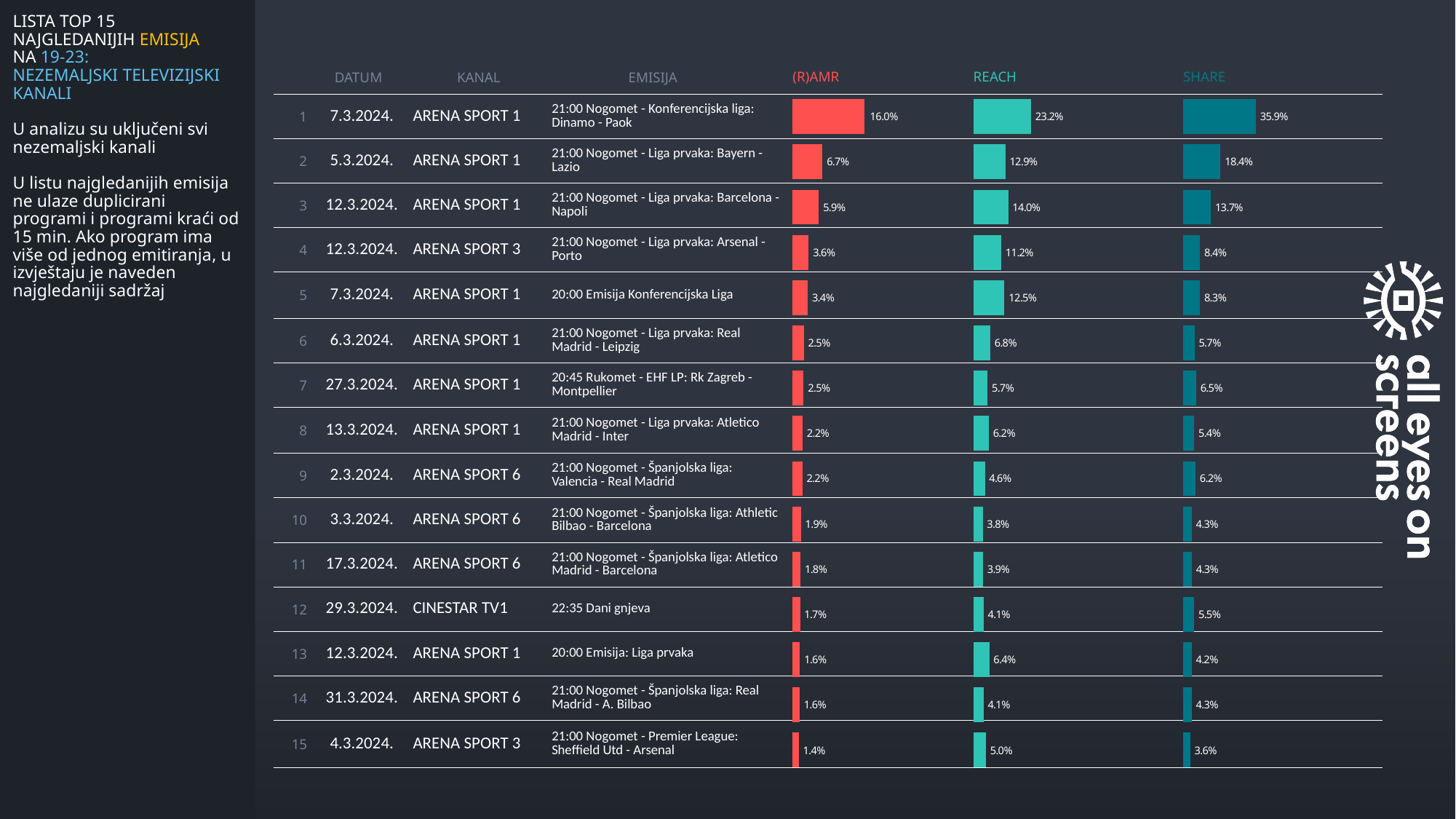
What is the REACH value for the rank 2 programme, 21:00 Nogomet - Liga prvaka: Bayern - Lazio? 12.9% Do the (R)AMR values rise or fall going down the list from rank 1 to rank 15? Fall Which programme has the highest SHARE value? 21:00 Nogomet - Konferencijska liga: Dinamo - Paok How many metric columns with bars are shown (R)AMR, REACH, SHARE)? 3 What is the (R)AMR value for the rank 1 programme, 21:00 Nogomet - Konferencijska liga: Dinamo - Paok? 16.0% Which has a higher REACH value: the rank 3 programme (Barcelona - Napoli) or the rank 5 programme (20:00 Emisija Konferencijska Liga)? 21:00 Nogomet - Liga prvaka: Barcelona - Napoli What colour are the bars in the (R)AMR column? Red What kind of chart is used to display the (R)AMR, REACH and SHARE values? Bar chart What is the SHARE value for the rank 4 programme, 21:00 Nogomet - Liga prvaka: Arsenal - Porto? 8.4% What is the difference in (R)AMR between the rank 1 programme (Dinamo - Paok) and the rank 2 programme (Bayern - Lazio)? 9.3% How many programmes are listed in the table? 15 Which programme has the lowest REACH value? 21:00 Nogomet - Španjolska liga: Athletic Bilbao - Barcelona